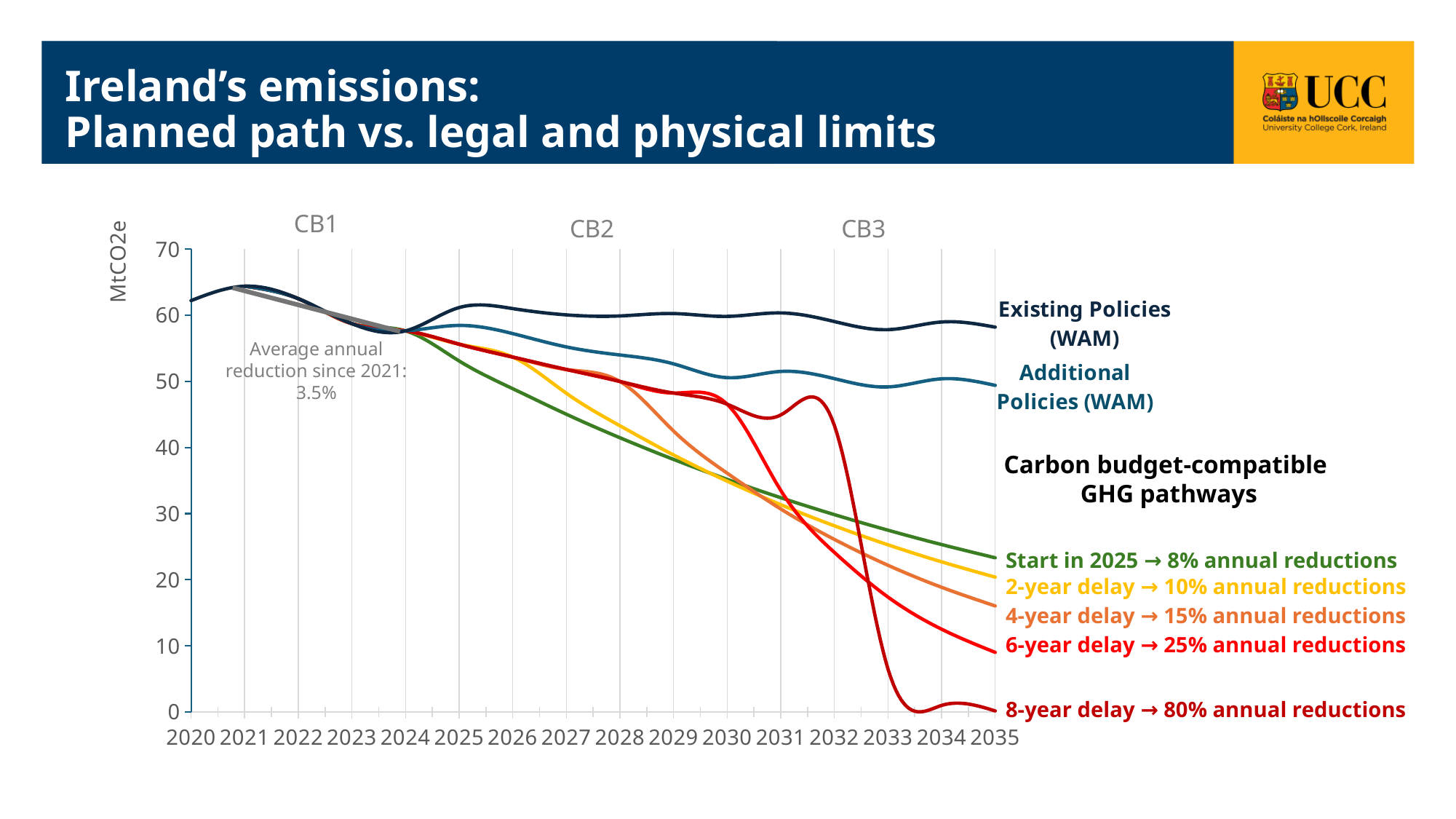
Does the 'Start in 2025' pathway rise or fall from 2025 to 2035? fall What kind of chart is shown on the slide? line chart What annual reduction rate is required under the 8-year delay pathway? 80% How many labelled series (lines) does the chart show? 7 Which series has the lowest value in 2035? 8-year delay → 80% annual reductions In 2035, which is higher: Existing Policies (WAM) or Additional Policies (WAM)? Existing Policies (WAM) What is the average annual reduction since 2021 stated on the chart? 3.5% Is the value for the 4-year delay pathway in 2035 greater or less than 20? less Which series has the highest value in 2035? Existing Policies (WAM) What annual reduction rate is required under the 4-year delay pathway? 15% What unit is shown on the y axis? MtCO2e Is the value for Existing Policies (WAM) in 2035 greater or less than 50? greater